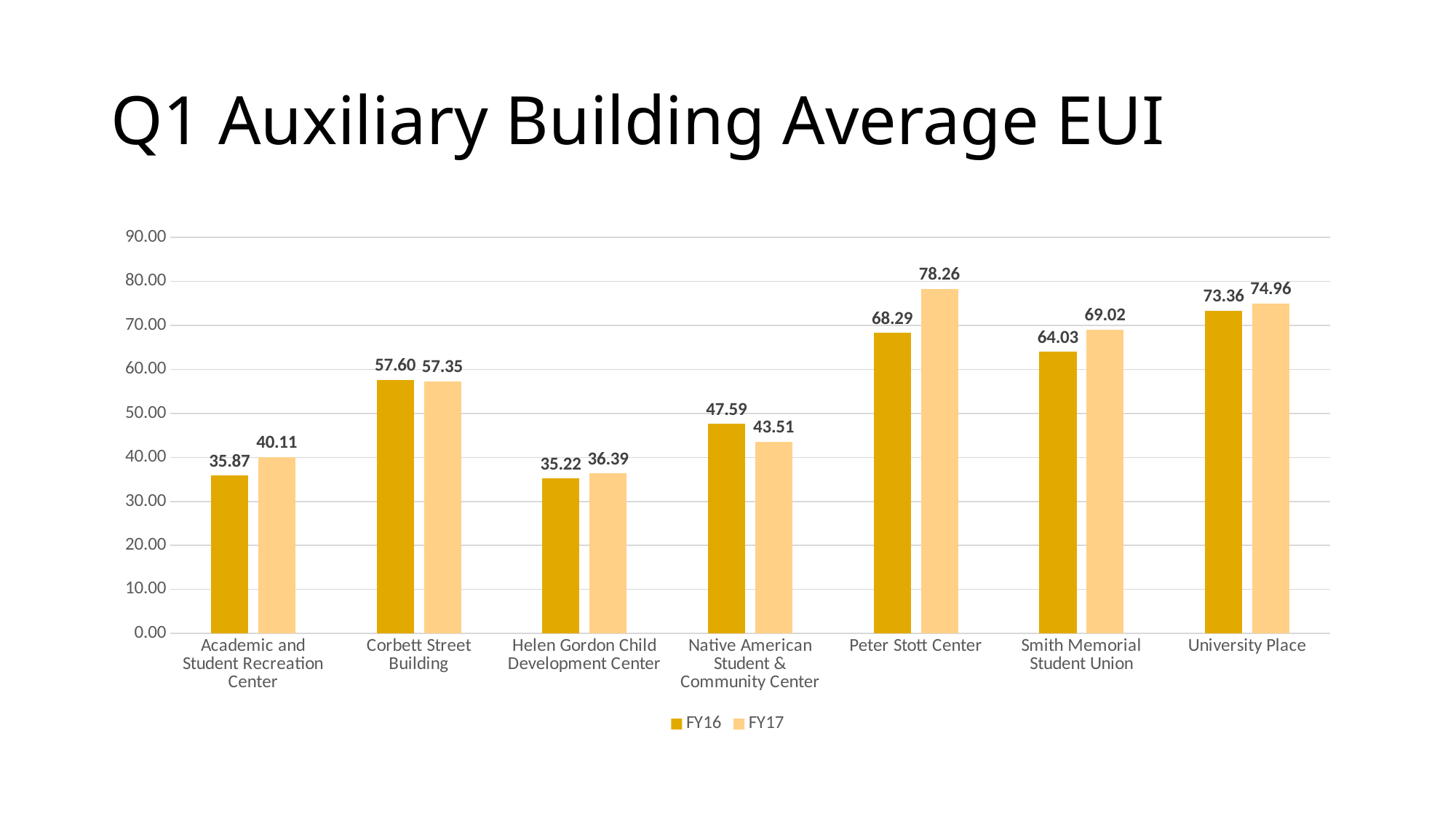
What kind of chart is shown on the slide? Bar chart Which is larger for Corbett Street Building, the FY16 value or the FY17 value? FY16 What is the difference between the FY17 and FY16 values for Smith Memorial Student Union? 4.99 What is the FY16 value for Peter Stott Center? 68.29 How many buildings are shown on the x axis? 7 What is the FY17 value for Native American Student & Community Center? 43.51 Which building has the lowest FY16 value? Helen Gordon Child Development Center Is the FY16 value for University Place greater or less than 70.00? greater How many series does the legend list? 2 What is the FY17 value for Academic and Student Recreation Center? 40.11 Which building has the highest FY17 value? Peter Stott Center What is the title of the chart? Q1 Auxiliary Building Average EUI